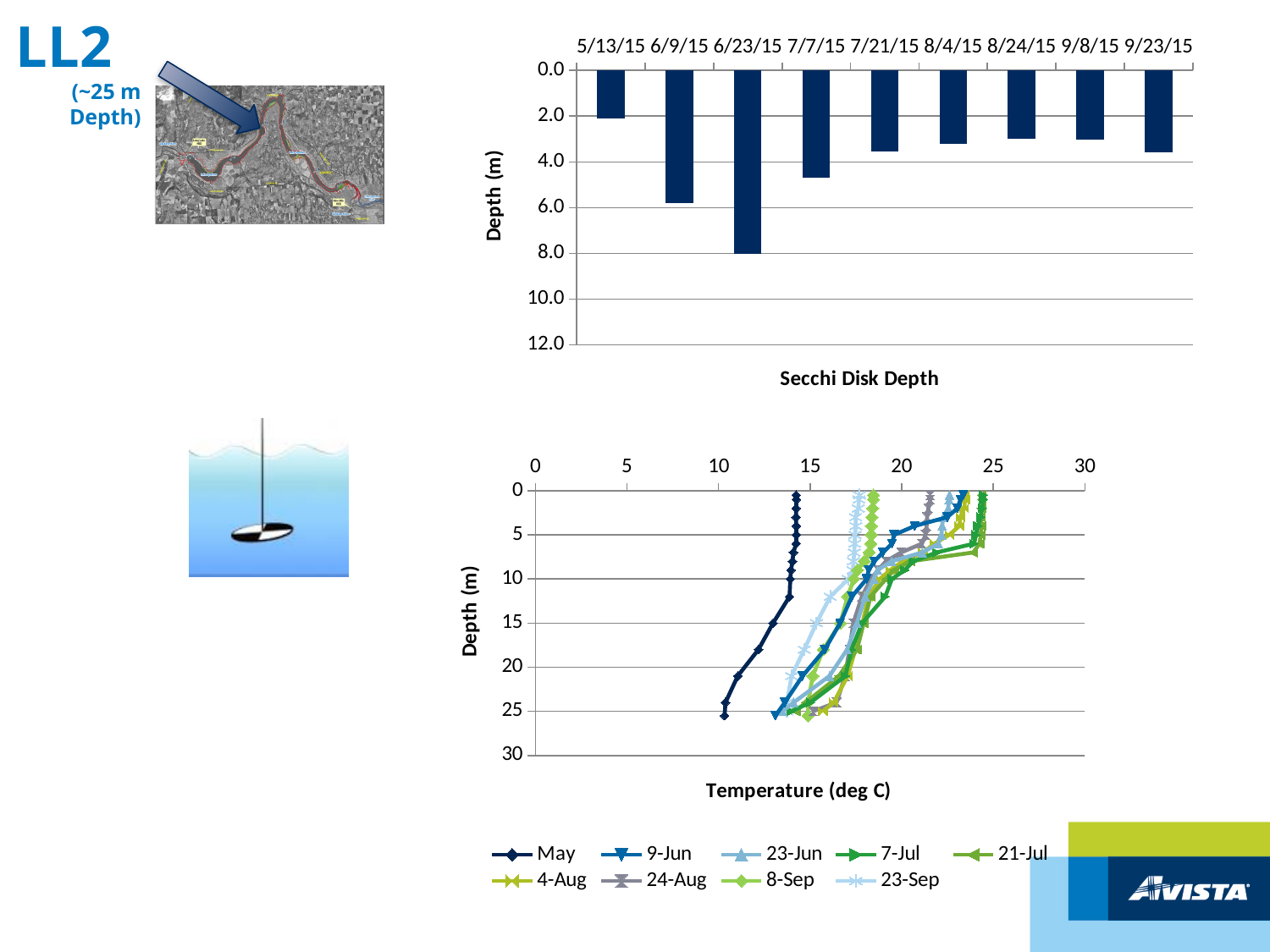
What is the y-axis label of the Secchi Disk Depth chart? Depth (m) What kind of chart is the Secchi Disk Depth chart? bar chart What kind of chart is the Temperature (deg C) chart? line chart In the Secchi Disk Depth chart, which date has the smallest depth? 5/13/15 In the Secchi Disk Depth chart, is the depth for 7/21/15 greater or less than 4.0? less In the Secchi Disk Depth chart, which date has a greater depth, 6/9/15 or 7/7/15? 6/9/15 How many sampling dates are shown in the Secchi Disk Depth chart? 9 In the Secchi Disk Depth chart, is the depth for 6/9/15 greater or less than 4.0? greater In the Secchi Disk Depth chart, which date has the greatest depth? 6/23/15 In the Temperature (deg C) chart, is the surface (0 m) temperature for the May series greater or less than 15? less How many series does the legend of the Temperature (deg C) chart list? 9